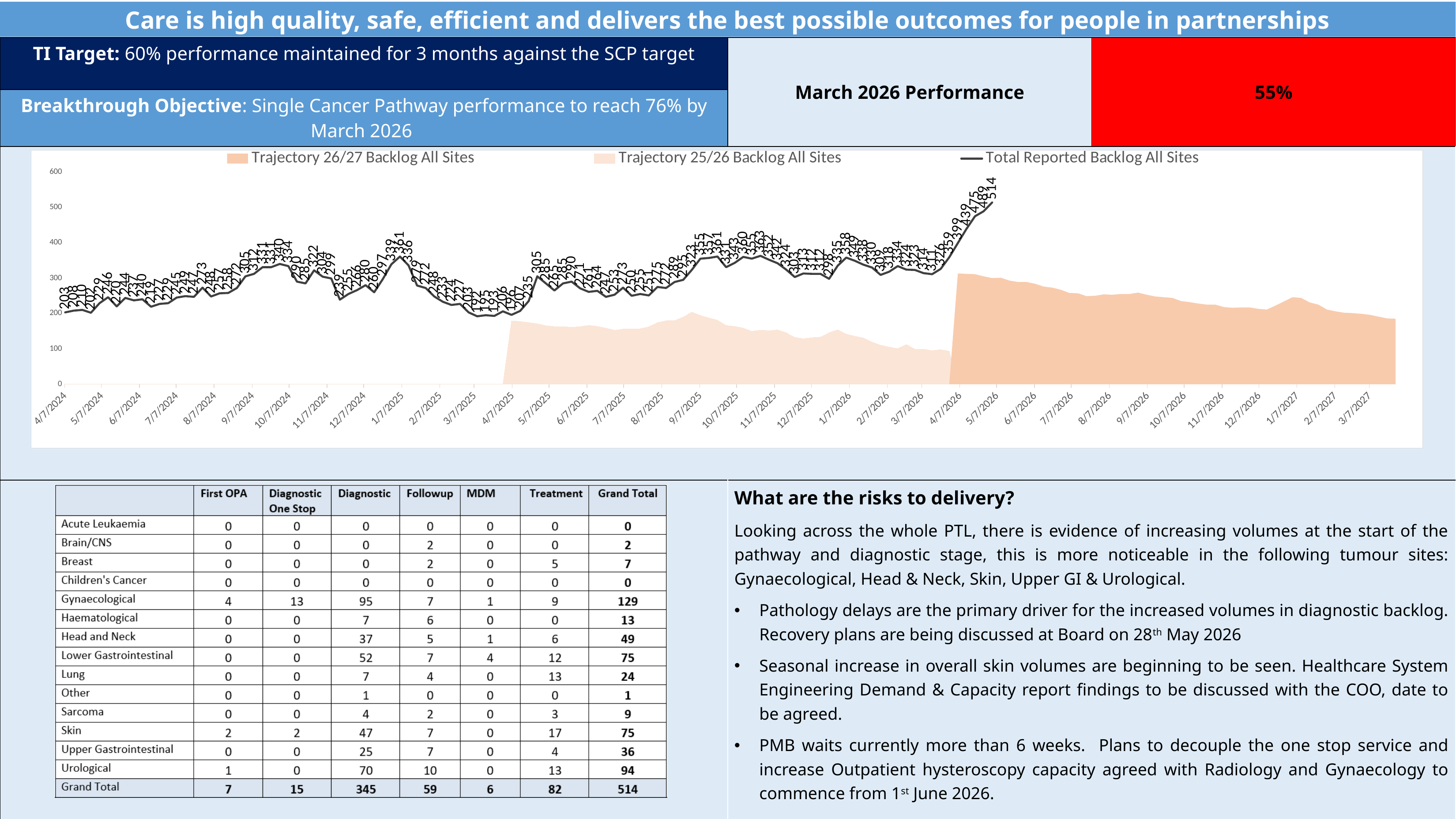
Is the Trajectory 25/26 Backlog All Sites value at 3/7/2026 greater or less than 200? less Is the Trajectory 26/27 Backlog All Sites value at 4/7/2026 greater or less than 400? less Is the Total Reported Backlog All Sites value at 4/7/2024 greater or less than 300? less Does the Total Reported Backlog All Sites line rise or fall between 3/7/2026 and 5/7/2026? rise What kind of chart is shown on the slide? A line chart with shaded area series Does the Trajectory 26/27 Backlog All Sites area rise or fall overall from 4/7/2026 to 3/7/2027? fall What is the highest tick value shown on the chart's vertical axis? 600 At 5/7/2026, which is larger: the Total Reported Backlog All Sites line or the Trajectory 26/27 Backlog All Sites area? Total Reported Backlog All Sites Which series is drawn as a dark line rather than a shaded area? Total Reported Backlog All Sites What is the final labelled value of the Total Reported Backlog All Sites line? 514 What is the highest labelled value on the Total Reported Backlog All Sites line? 514 How many series does the chart legend list? 3